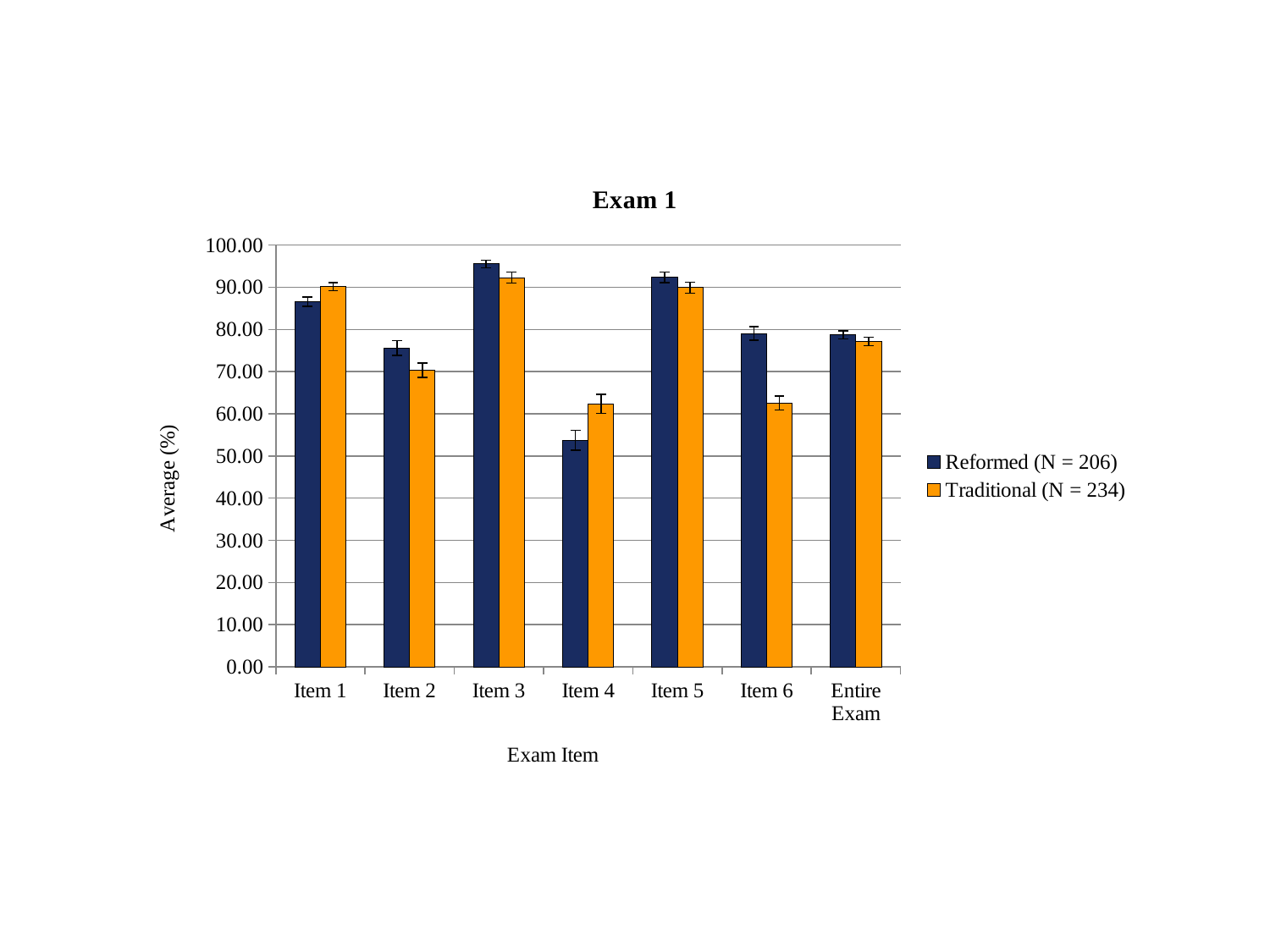
Is the Reformed (N = 206) value for Item 3 greater or less than 90.00? greater Which exam item has the highest value for the Reformed (N = 206) series? Item 3 What kind of chart is shown on the slide? bar chart What is the title of the chart? Exam 1 For Item 4, which series has the larger value, Reformed (N = 206) or Traditional (N = 234)? Traditional (N = 234) How many categories are shown on the x axis? 7 Which exam item has the lowest value for the Reformed (N = 206) series? Item 4 For Item 6, which series has the larger value, Reformed (N = 206) or Traditional (N = 234)? Reformed (N = 206) What is the label of the y axis? Average (%) Is the Reformed (N = 206) value for Item 4 greater or less than 60.00? less How many series does the legend list? 2 Is the Traditional (N = 234) value for Item 6 greater or less than 70.00? less